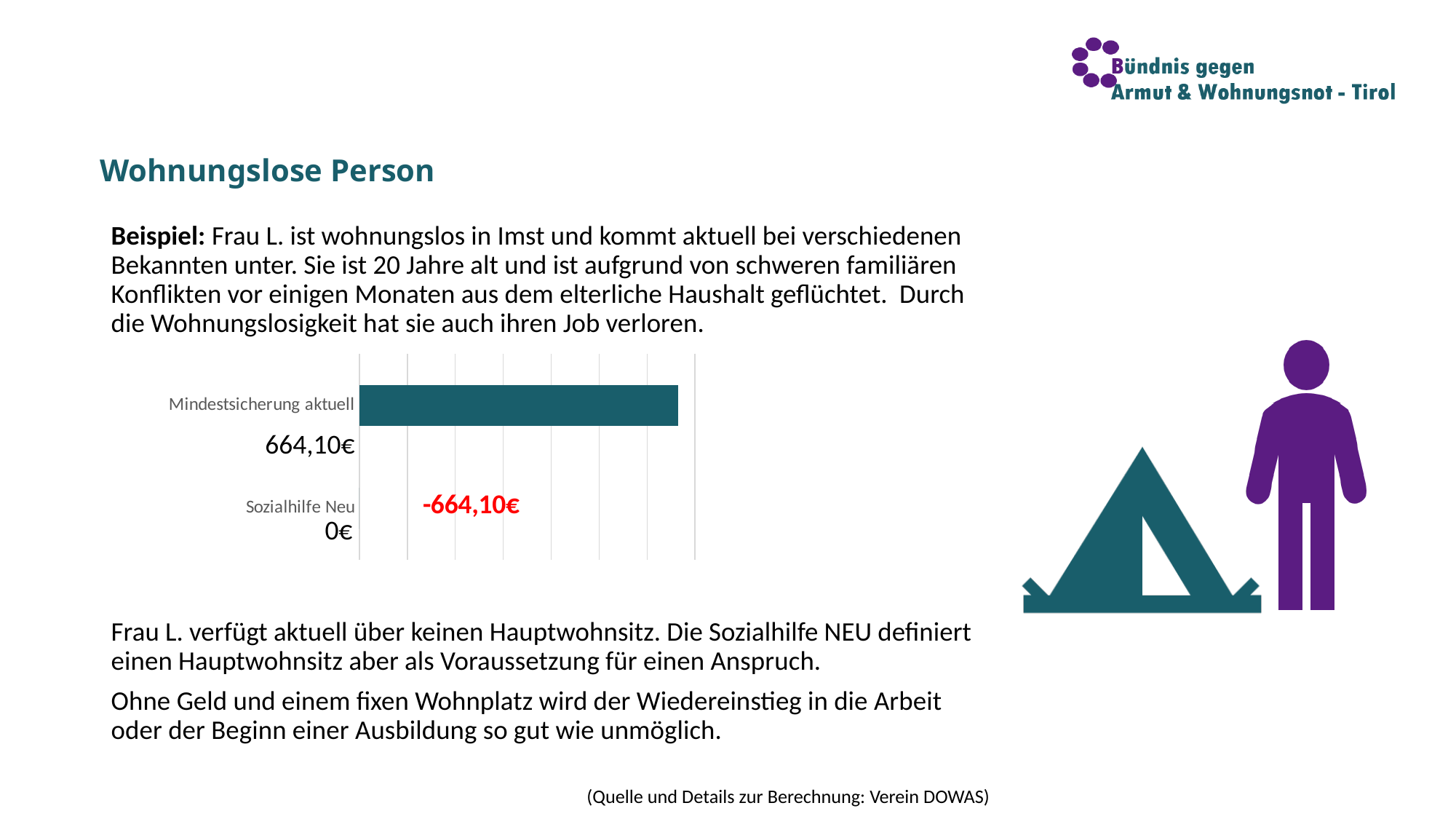
Is the value for Sozialhilfe Neu larger or smaller than the value for Mindestsicherung aktuell? smaller Which category has the higher value in the bar chart? Mindestsicherung aktuell How many categories are shown in the bar chart? 2 What is the value for Sozialhilfe Neu in the bar chart? 0€ Which category has the lowest value in the bar chart? Sozialhilfe Neu What is the value for Mindestsicherung aktuell in the bar chart? 664,10€ What colour is the bar for Mindestsicherung aktuell in the chart? dark teal What is the difference between Mindestsicherung aktuell and Sozialhilfe Neu in the bar chart? 664,10€ What change is printed in red next to the Sozialhilfe Neu bar in the chart? -664,10€ What kind of chart is shown on the slide? bar chart